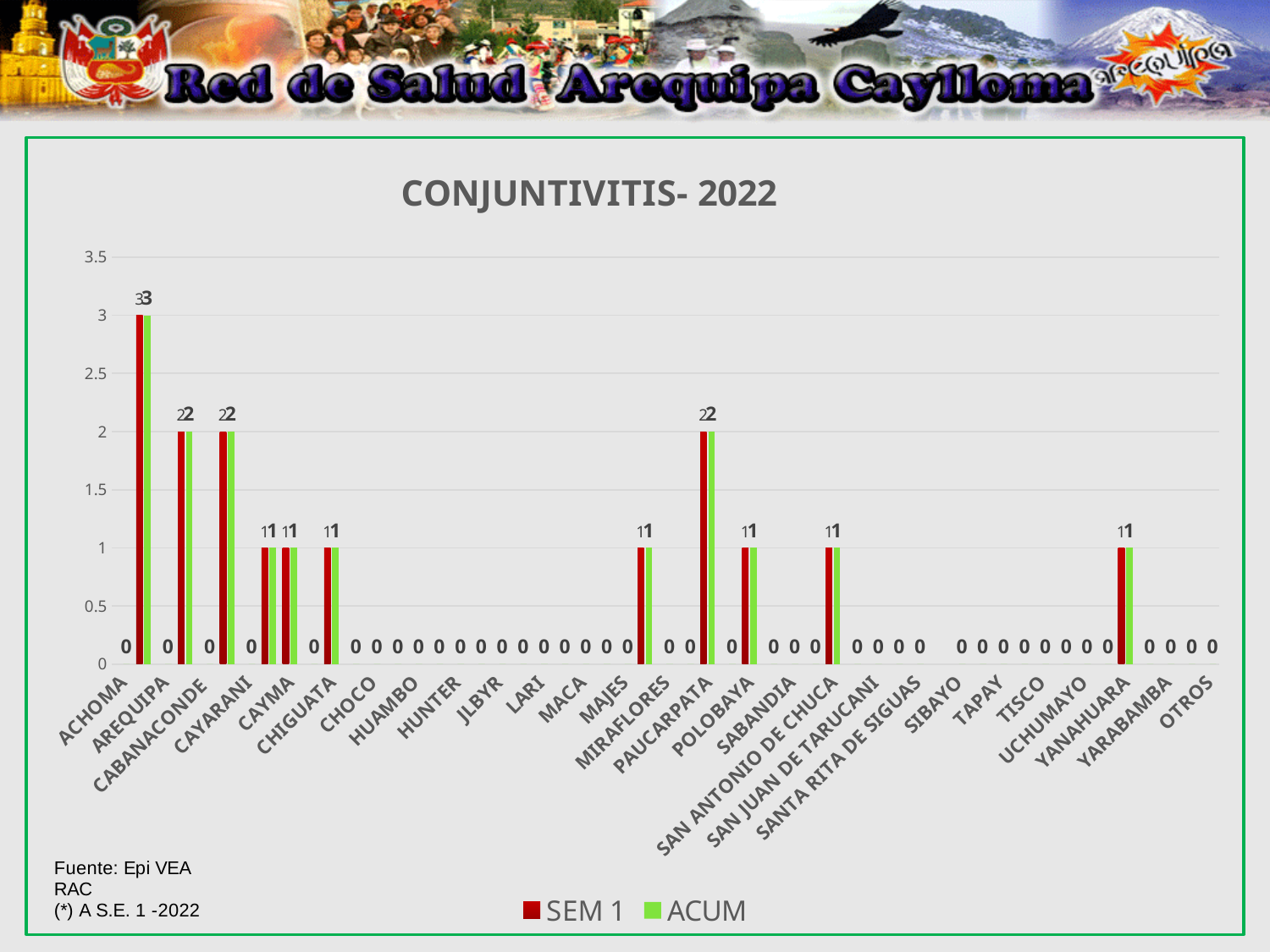
How many categories are shown on the x axis? 27 How many series does the legend list? 2 What kind of chart is shown on the slide? Bar chart What is the ACUM value for PAUCARPATA? 2 What is the SEM 1 value for CHOCO? 0 What is the title of the chart? CONJUNTIVITIS- 2022 What are the two series named in the legend? SEM 1 and ACUM Which has a larger SEM 1 value, AREQUIPA or CAYMA? CAYMA What is the ACUM value for YANAHUARA? 1